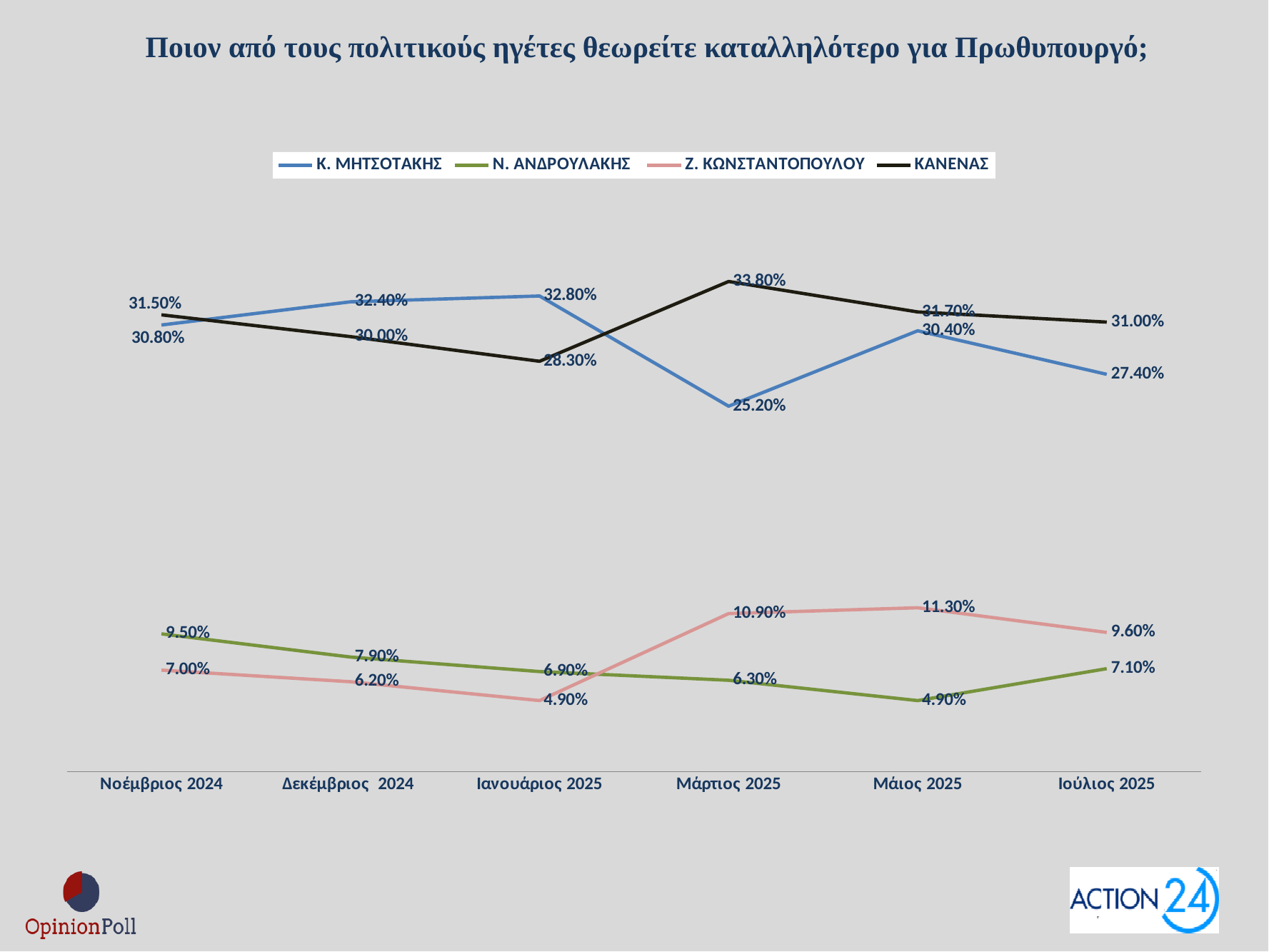
What is the difference between ΚΑΝΕΝΑΣ and Κ. ΜΗΤΣΟΤΑΚΗΣ in Μάρτιος 2025? 8.60% In which month does Κ. ΜΗΤΣΟΤΑΚΗΣ have its lowest value? Μάρτιος 2025 What is the value for Ν. ΑΝΔΡΟΥΛΑΚΗΣ in Ιούλιος 2025? 7.10% How many series does the legend list? 4 Does the value for Ν. ΑΝΔΡΟΥΛΑΚΗΣ rise or fall from Νοέμβριος 2024 to Μάιος 2025? fall What is the value for Ζ. ΚΩΝΣΤΑΝΤΟΠΟΥΛΟΥ in Μάιος 2025? 11.30% In which month does ΚΑΝΕΝΑΣ reach its highest value? Μάρτιος 2025 What is the value for ΚΑΝΕΝΑΣ in Ιανουάριος 2025? 28.30% How many time points are shown on the x axis? 6 What type of chart is shown on the slide? line chart What is the value for Κ. ΜΗΤΣΟΤΑΚΗΣ in Μάρτιος 2025? 25.20% Which is larger in Ιούλιος 2025, Ζ. ΚΩΝΣΤΑΝΤΟΠΟΥΛΟΥ or Ν. ΑΝΔΡΟΥΛΑΚΗΣ? Ζ. ΚΩΝΣΤΑΝΤΟΠΟΥΛΟΥ